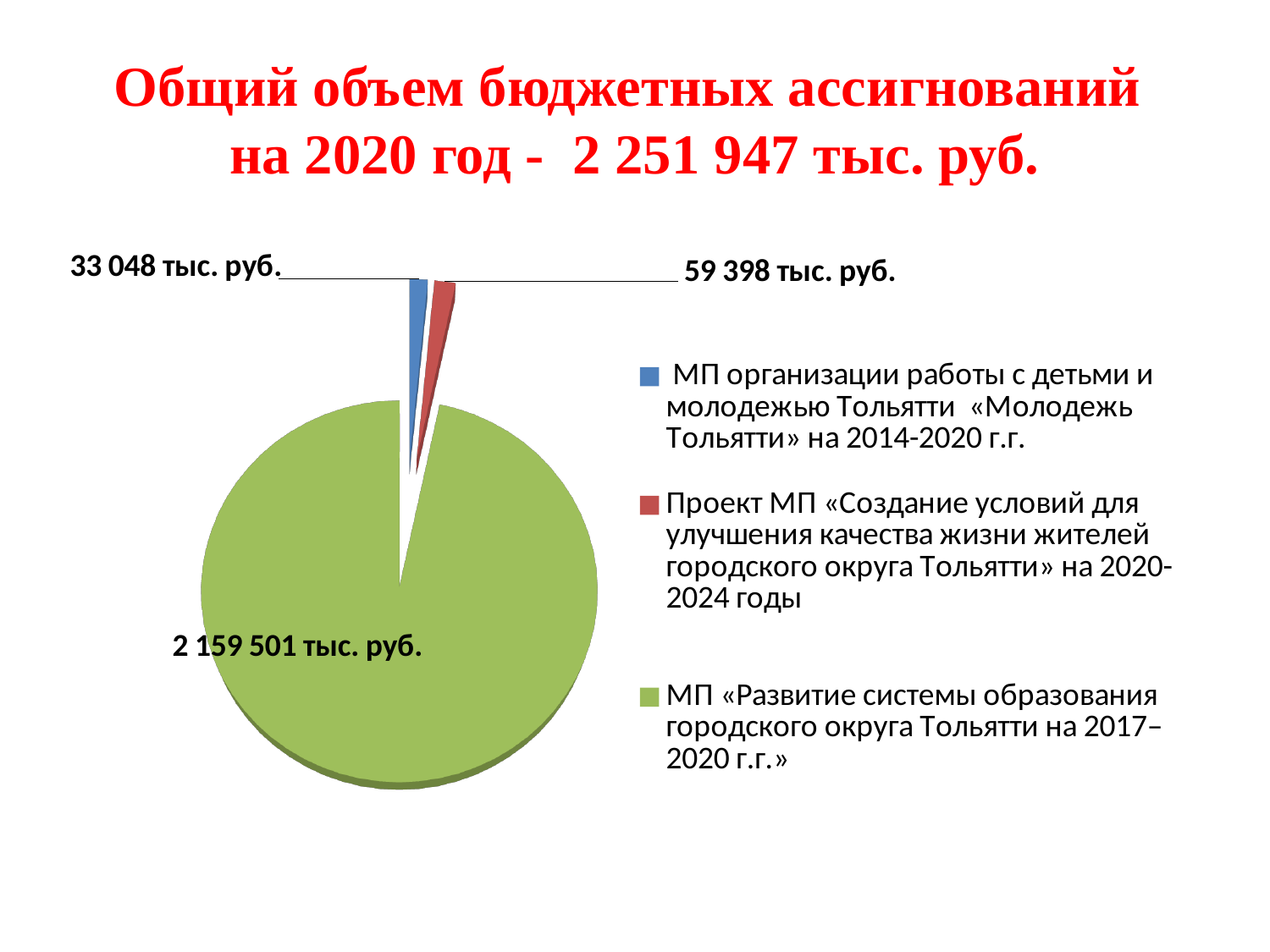
What is the total of the three values shown on the pie chart? 2 251 947 тыс. руб. Which is larger: the value for Проект МП «Создание условий для улучшения качества жизни жителей городского округа Тольятти» or the value for МП «Молодежь Тольятти»? Проект МП «Создание условий для улучшения качества жизни жителей городского округа Тольятти» What is the value for МП «Развитие системы образования городского округа Тольятти на 2017–2020 г.г.»? 2 159 501 тыс. руб. Which programme has the largest slice of the pie? МП «Развитие системы образования городского округа Тольятти на 2017–2020 г.г.» What is the value for МП организации работы с детьми и молодежью Тольятти «Молодежь Тольятти» на 2014-2020 г.г.? 33 048 тыс. руб. Which programme has the smallest slice of the pie? МП организации работы с детьми и молодежью Тольятти «Молодежь Тольятти» на 2014-2020 г.г. What colour is the slice for МП «Развитие системы образования городского округа Тольятти на 2017–2020 г.г.»? green What is the value for Проект МП «Создание условий для улучшения качества жизни жителей городского округа Тольятти» на 2020-2024 годы? 59 398 тыс. руб. How many entries does the legend list? 3 What kind of chart is shown on the slide? pie chart What is the difference between the value for Проект МП «Создание условий для улучшения качества жизни жителей городского округа Тольятти» (59 398 тыс. руб.) and the value for МП «Молодежь Тольятти» (33 048 тыс. руб.)? 26 350 тыс. руб. How many slices does the pie chart have? 3